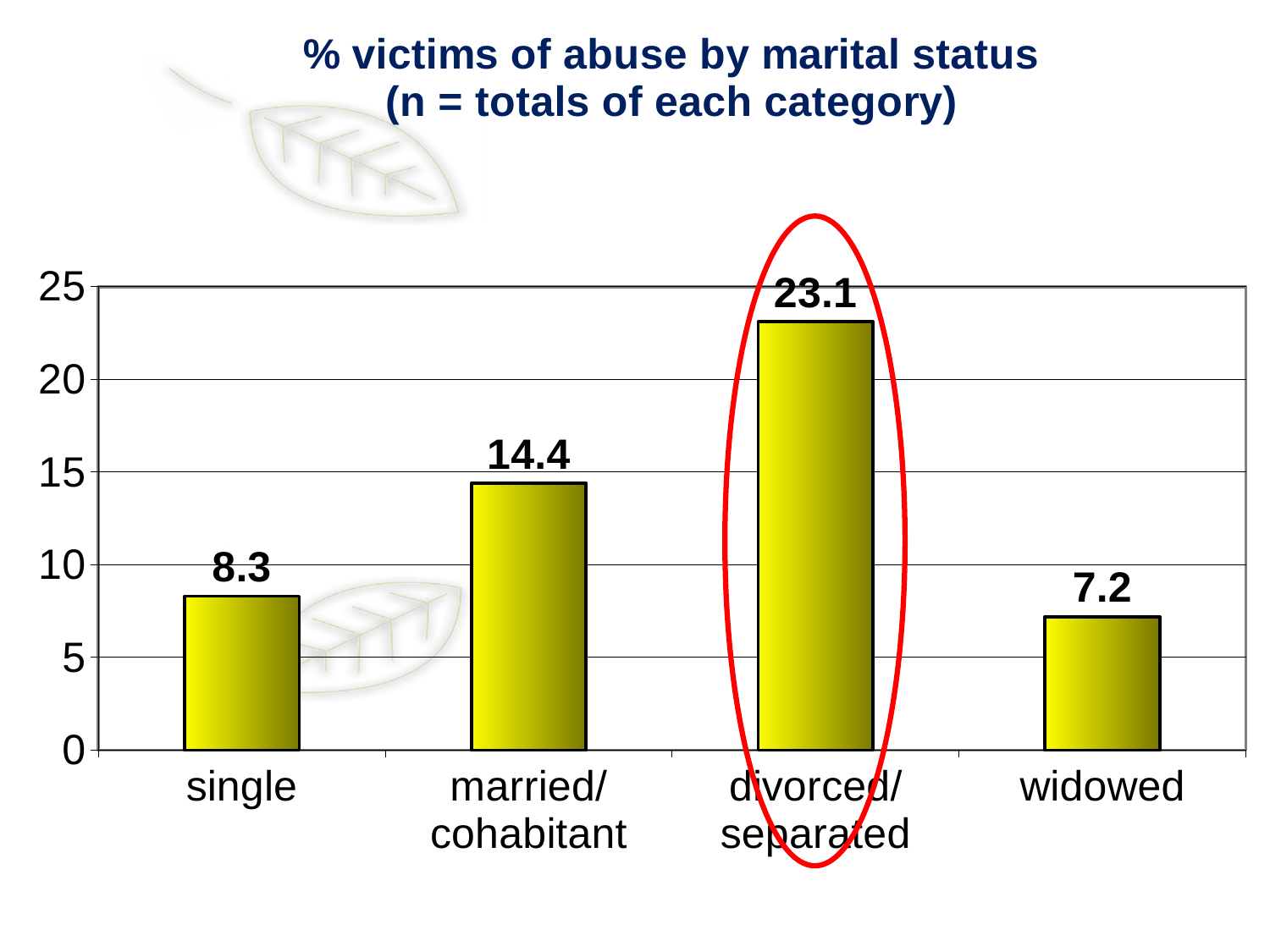
What is the difference between the values for divorced/separated and married/cohabitant? 8.7 What is the value for divorced/separated? 23.1 How many marital status categories are shown in the chart? 4 What is the difference between the values for single and widowed? 1.1 Which is larger, the value for single or the value for married/cohabitant? married/cohabitant Is the value for divorced/separated greater or less than 20? greater What is the value for widowed? 7.2 What kind of chart is shown on the slide? bar chart Which marital status category has the lowest value? widowed What is the value for single? 8.3 What is the value for married/cohabitant? 14.4 Which marital status category has the highest value? divorced/separated